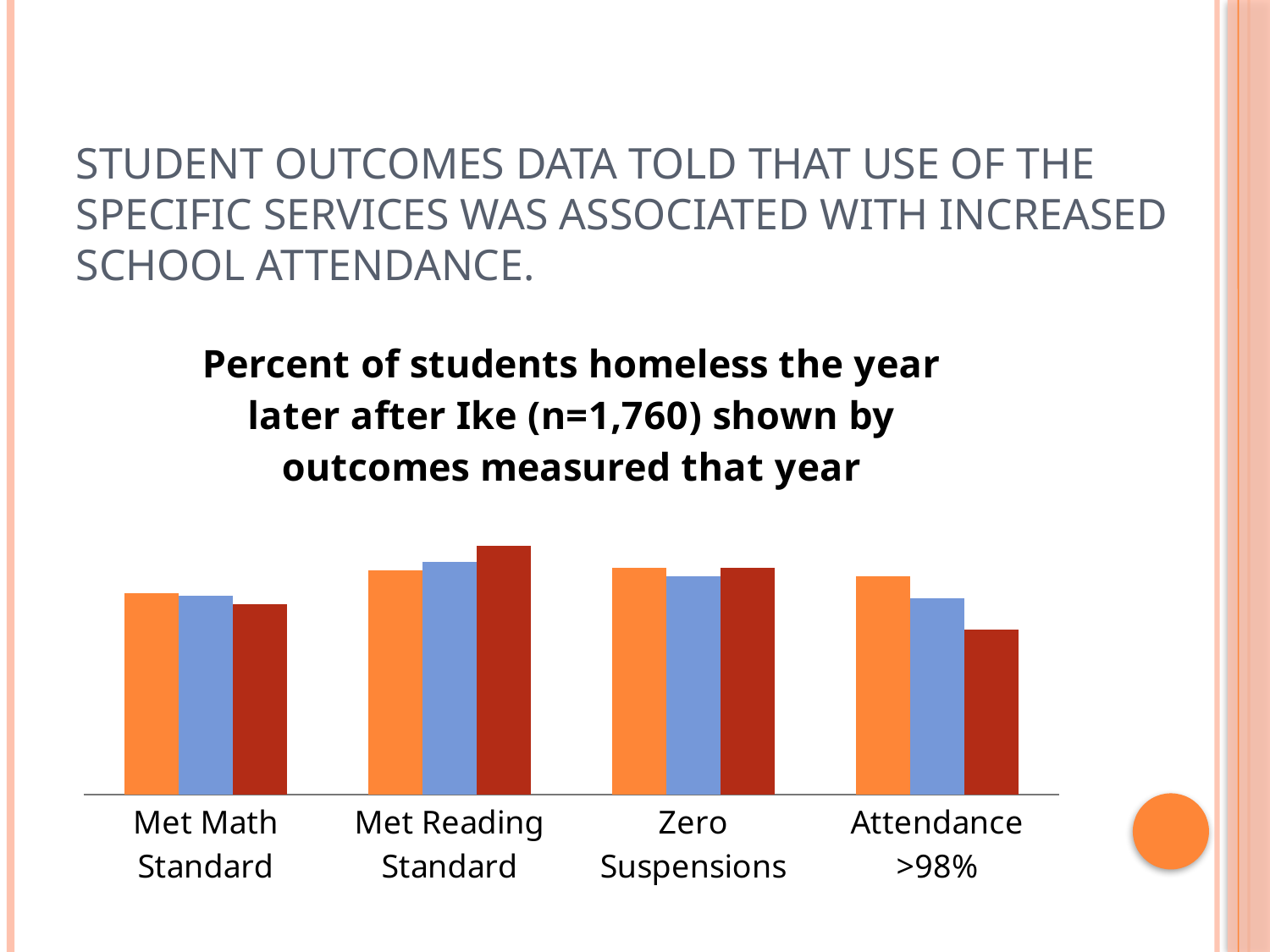
For Attendance >98%, which is taller: the orange bar or the dark red bar? the orange bar In which category is the dark red bar the shortest? Attendance >98% What is the label of the rightmost category on the x axis? Attendance >98% How many bars are plotted for each category in the chart? 3 Within the Met Reading Standard category, do the bars rise or fall from left to right? rise For Met Reading Standard, which is taller: the orange bar or the dark red bar? the dark red bar How many categories are shown along the x axis of the chart? 4 In which category is the orange bar the shortest? Met Math Standard Within the Attendance >98% category, do the bars rise or fall from left to right? fall What is the title of the chart? Percent of students homeless the year later after Ike (n=1,760) shown by outcomes measured that year In which category is the dark red bar the tallest? Met Reading Standard What kind of chart is shown on the slide? bar chart